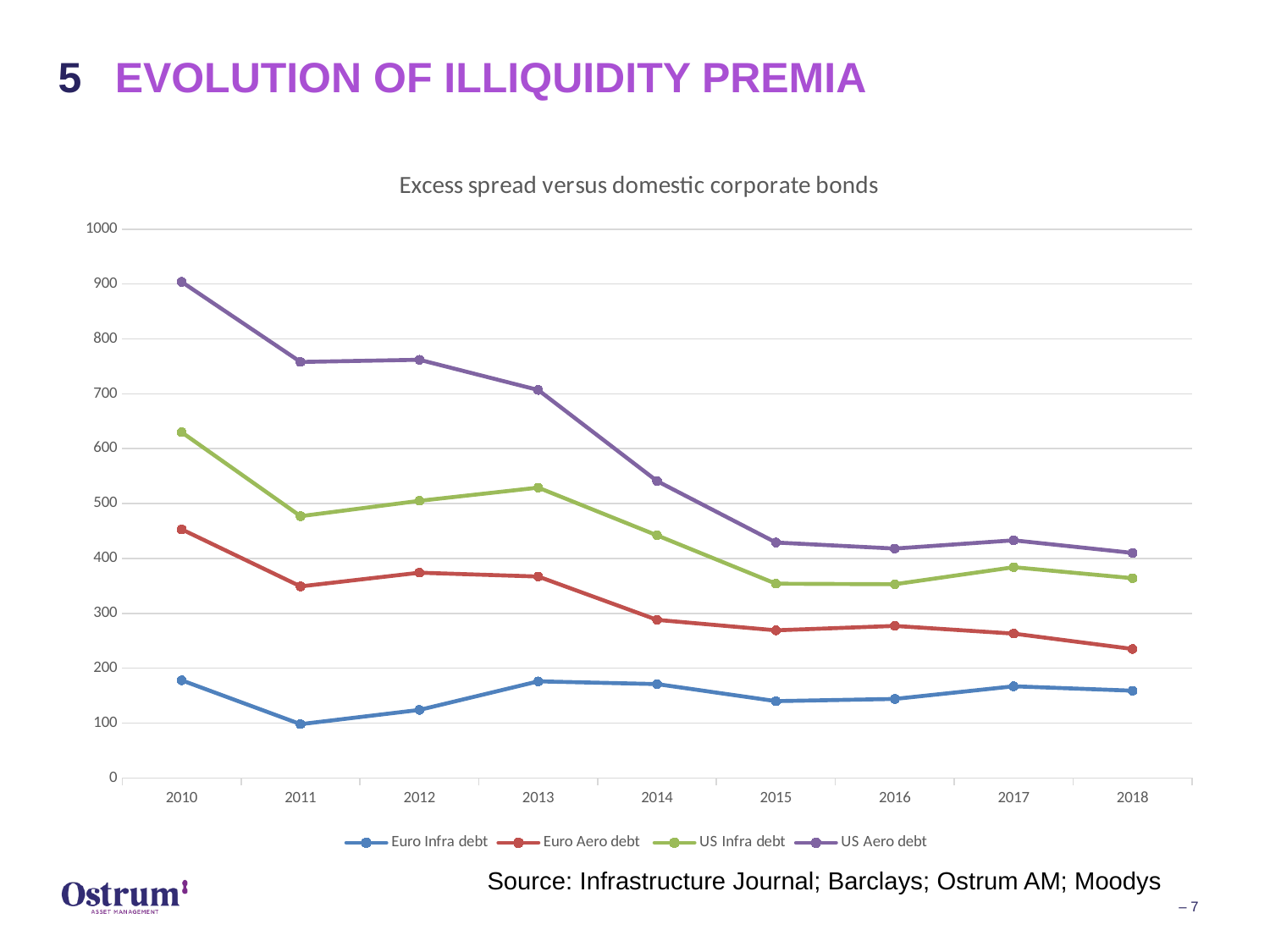
What kind of chart is shown on the slide? Line chart What is the title of the chart? Excess spread versus domestic corporate bonds Is the value for Euro Infra debt in 2011 greater or less than 150? less Is the value for US Infra debt in 2010 greater or less than 600? greater Is the value for US Aero debt in 2010 greater or less than 800? greater How many series does the legend list? 4 Which series has the lowest value in 2018? Euro Infra debt In which year is US Infra debt at its highest? 2010 How many years are shown on the x axis? 9 Which series has the highest value in 2010? US Aero debt Does the US Aero debt series rise or fall overall from 2010 to 2018? Fall